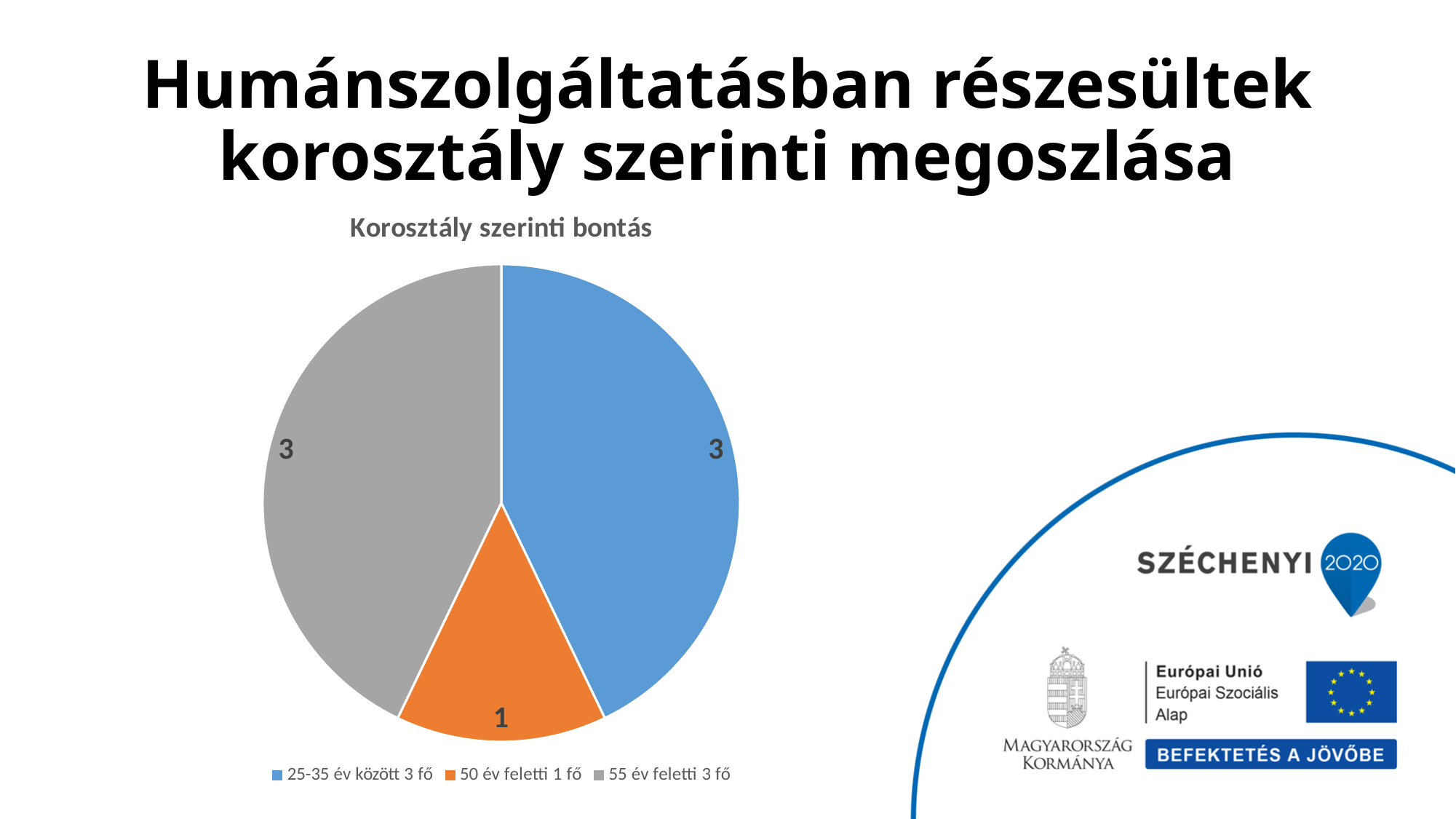
How many slices does the pie chart have? 3 What is the total of all the values in the pie chart? 7 What is the value shown for the '25-35 év között 3 fő' slice? 3 Which colour represents the '50 év feletti 1 fő' category in the pie chart? orange How many entries does the legend list? 3 What is the title of the chart? Korosztály szerinti bontás Which category has the smallest slice in the pie chart? 50 év feletti 1 fő What is the difference between the '55 év feletti' value and the '50 év feletti' value? 2 What is the value shown for the '50 év feletti 1 fő' slice? 1 What is the value shown for the '55 év feletti 3 fő' slice? 3 Which is larger: the '25-35 év között' slice or the '50 év feletti' slice? 25-35 év között What kind of chart is shown on the slide? pie chart